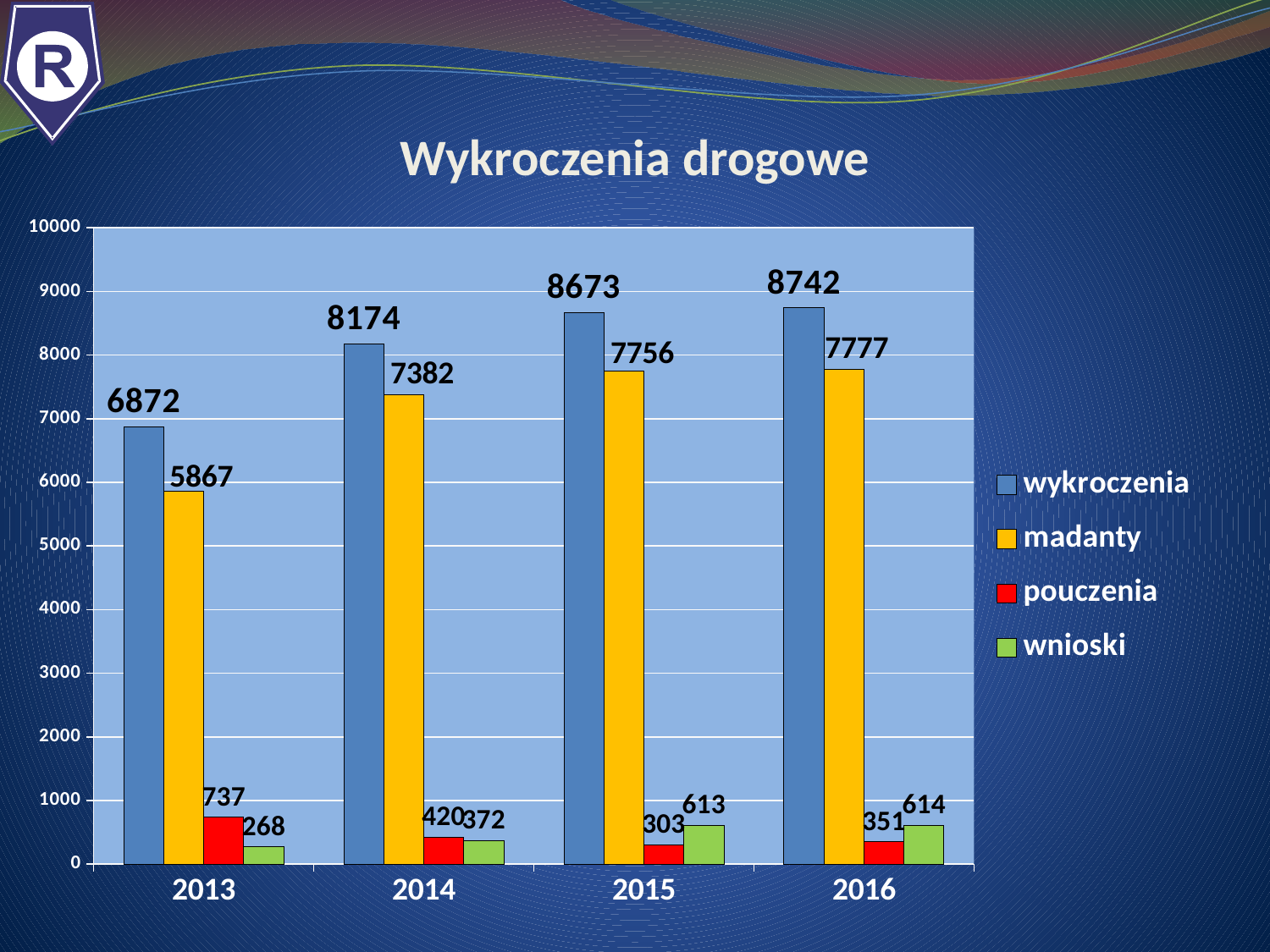
In which year is the value of wykroczenia highest? 2016 What is the value of pouczenia for 2014? 420 What is the value of wnioski for 2015? 613 What is the value of wykroczenia for 2013? 6872 How many series does the legend list? 4 In which year is the value of wnioski lowest? 2013 What is the difference between wykroczenia and madanty in 2015? 917 Does the value of madanty rise or fall from 2013 to 2016? rise How many years are shown on the x axis? 4 Which is larger in 2013: pouczenia or wnioski? pouczenia What is the value of madanty for 2016? 7777 What kind of chart is shown on the slide? bar chart